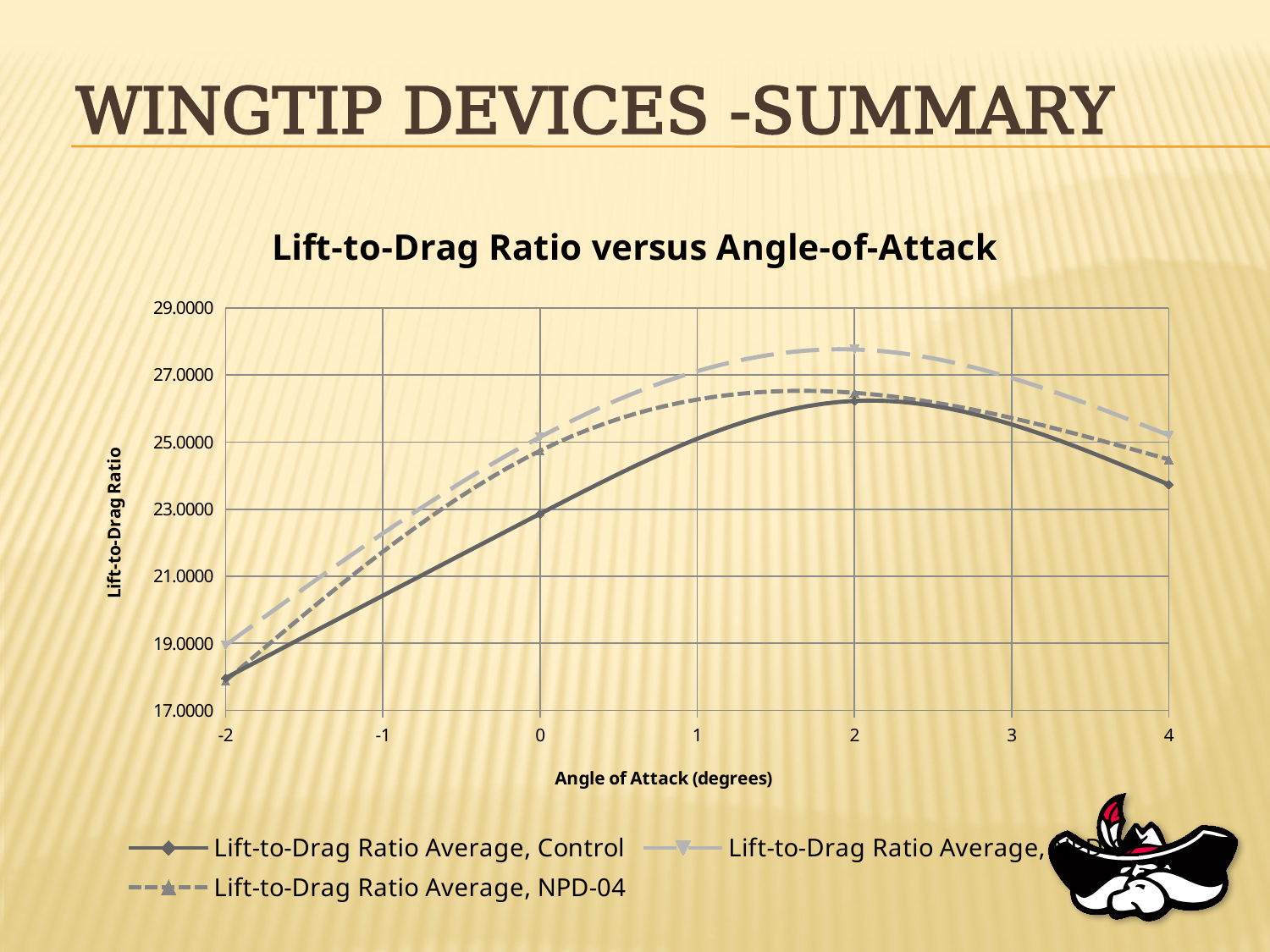
How many series does the legend list? 3 Is the value for Lift-to-Drag Ratio Average, Control at an angle of attack of -2 greater or less than 19.0000? less At which angle of attack does the Lift-to-Drag Ratio Average, Control series reach its highest value? 2 Is the value for Lift-to-Drag Ratio Average, Control at an angle of attack of 2 greater or less than 25.0000? greater What kind of chart is shown on the slide? Line chart Is the value for Lift-to-Drag Ratio Average, NPD-04 at an angle of attack of 4 greater or less than 25.0000? less What is the title of the chart? Lift-to-Drag Ratio versus Angle-of-Attack At which angle of attack does the Lift-to-Drag Ratio Average, Control series have its lowest value? -2 How many angle-of-attack values are marked on the x axis? 7 What is the label of the x axis? Angle of Attack (degrees) At an angle of attack of 4, which series has the larger value: Lift-to-Drag Ratio Average, Control or Lift-to-Drag Ratio Average, NPD-04? Lift-to-Drag Ratio Average, NPD-04